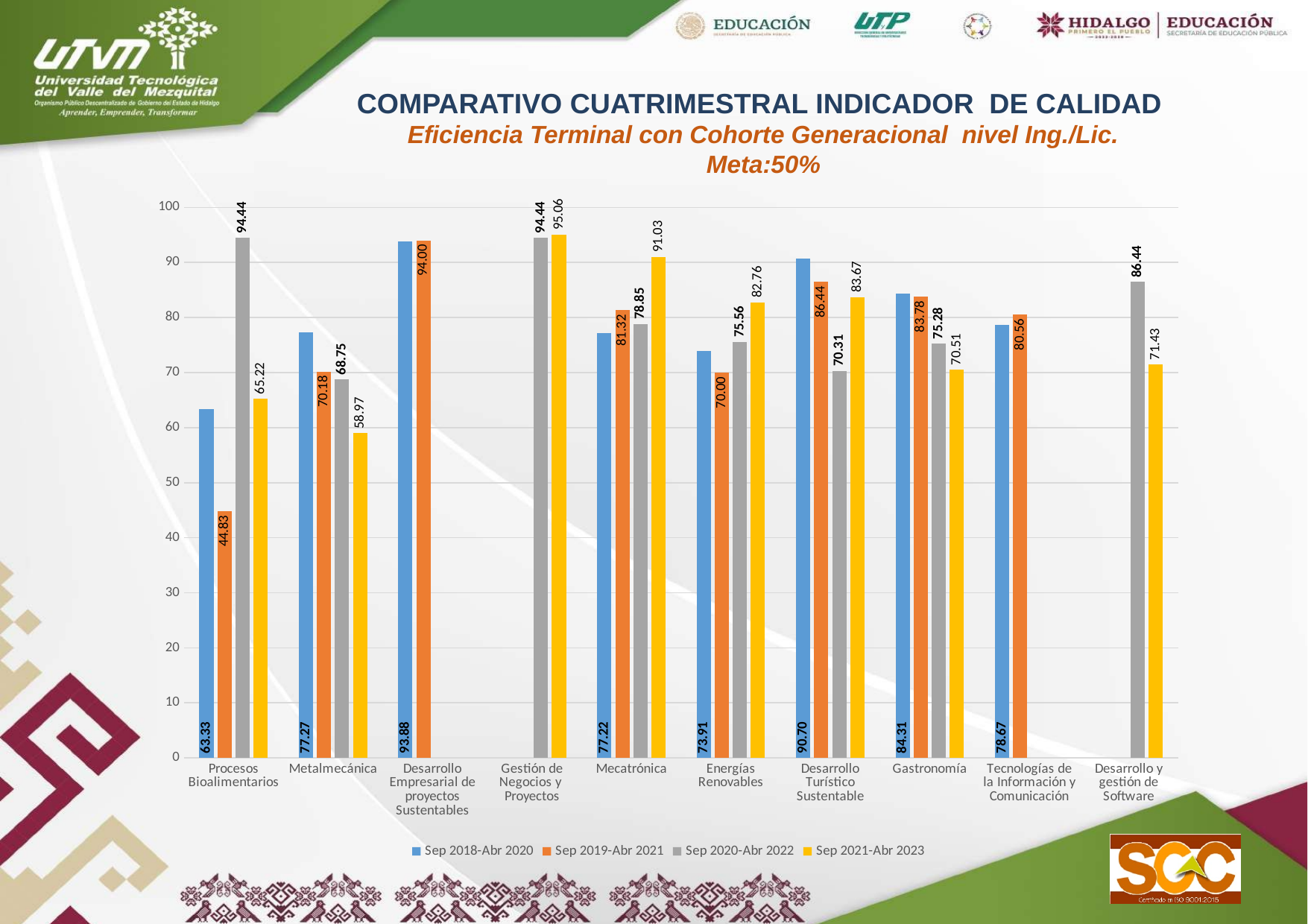
For Desarrollo Turístico Sustentable, which is larger: the Sep 2018-Abr 2020 value or the Sep 2020-Abr 2022 value? Sep 2018-Abr 2020 Do the values for Gastronomía rise or fall across the four series from Sep 2018-Abr 2020 to Sep 2021-Abr 2023? fall What is the value for Procesos Bioalimentarios in the Sep 2019-Abr 2021 series? 44.83 How many series does the legend list? 4 What target (Meta) is stated in the chart title? 50% What is the value for Mecatrónica in the Sep 2021-Abr 2023 series? 91.03 Which category has the lowest value in the Sep 2019-Abr 2021 series? Procesos Bioalimentarios What is the difference between the Sep 2018-Abr 2020 and Sep 2021-Abr 2023 values for Metalmecánica? 18.30 Which category has the highest value in the Sep 2021-Abr 2023 series? Gestión de Negocios y Proyectos What type of chart is shown on the slide? bar chart What is the value for Desarrollo y gestión de Software in the Sep 2020-Abr 2022 series? 86.44 How many program categories are shown on the x axis? 10